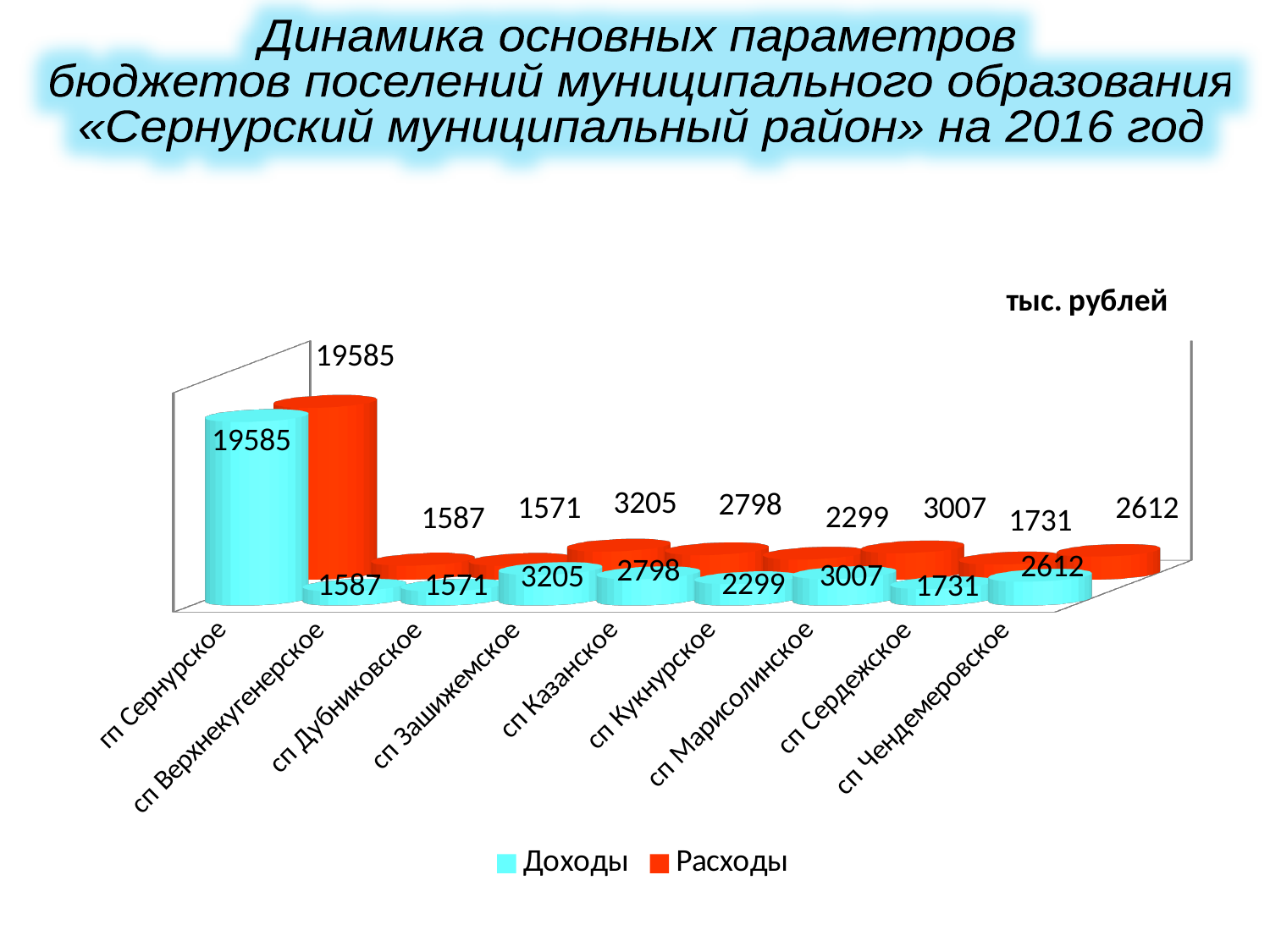
How many settlements (categories) are shown on the x axis? 9 How many series does the legend list? 2 What is the value of Доходы for гп Сернурское? 19585 What is the value of Расходы for сп Казанское? 2798 What is the value of Доходы for сп Марисолинское? 3007 Which is larger, the Расходы value for сп Кукнурское or for сп Марисолинское? сп Марисолинское Which settlement has the lowest Расходы value? сп Дубниковское What is the difference between the Доходы values for сп Зашижемское and сп Сердежское? 1474 What unit is indicated above the chart? тыс. рублей What kind of chart is shown on the slide? bar chart Which settlement has the highest Доходы value? гп Сернурское What is the value of Расходы for сп Чендемеровское? 2612